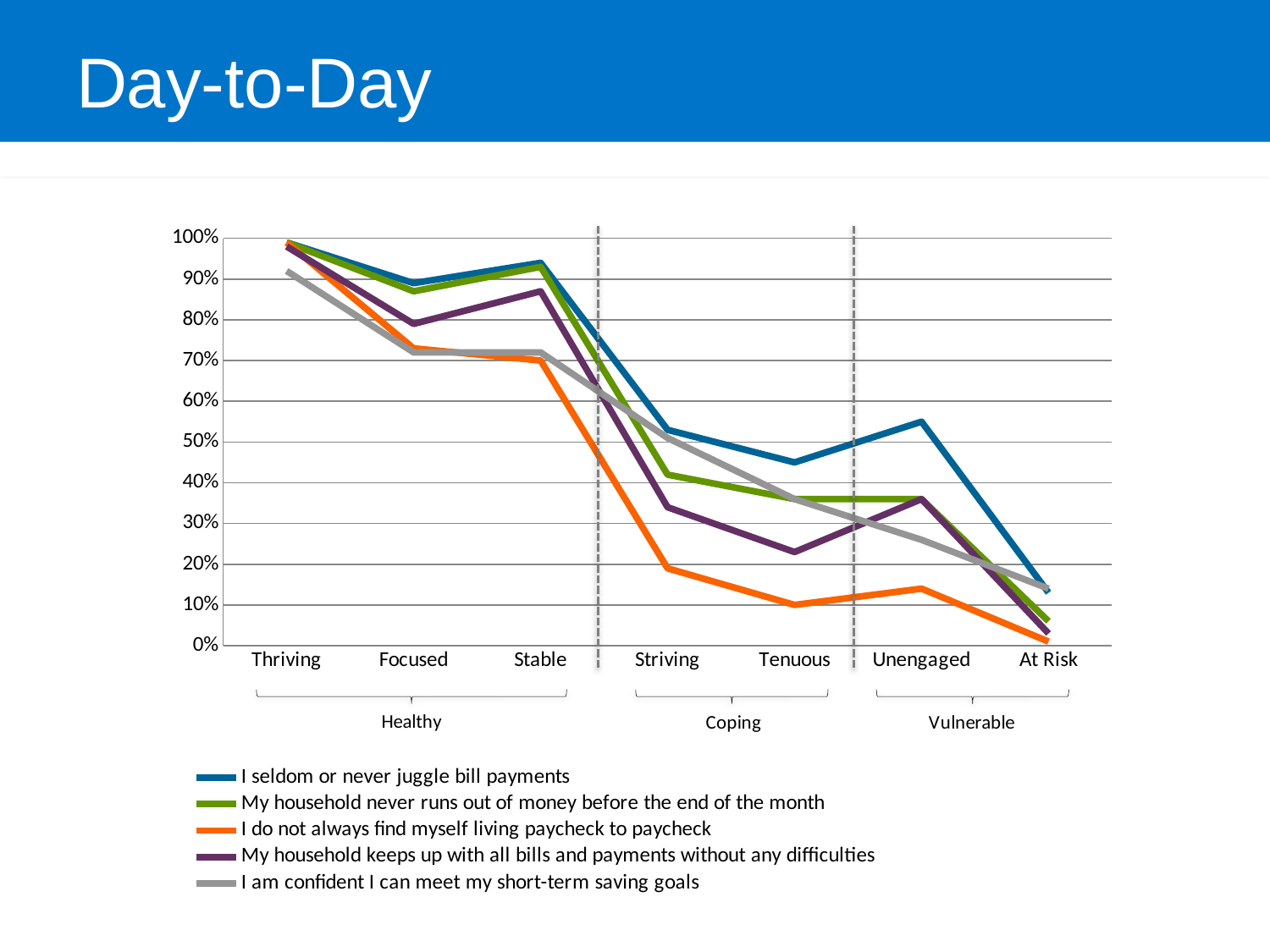
At Striving, which is larger: "I seldom or never juggle bill payments" or "I do not always find myself living paycheck to paycheck"? I seldom or never juggle bill payments What are the three group labels shown beneath the x-axis categories? Healthy, Coping, Vulnerable Is the value for "My household keeps up with all bills and payments without any difficulties" at Focused greater or less than 70%? greater Is the value for "I do not always find myself living paycheck to paycheck" at Tenuous greater or less than 20%? less Does the value for "I do not always find myself living paycheck to paycheck" rise or fall from Thriving to Tenuous? fall At At Risk, which series has the lowest value? I do not always find myself living paycheck to paycheck Is the value for "I seldom or never juggle bill payments" at Unengaged greater or less than 50%? greater What is the title of the slide containing the chart? Day-to-Day What kind of chart is shown on the slide? line chart For "I seldom or never juggle bill payments", which category has the lowest value? At Risk How many categories are shown along the x axis? 7 How many series does the legend list? 5